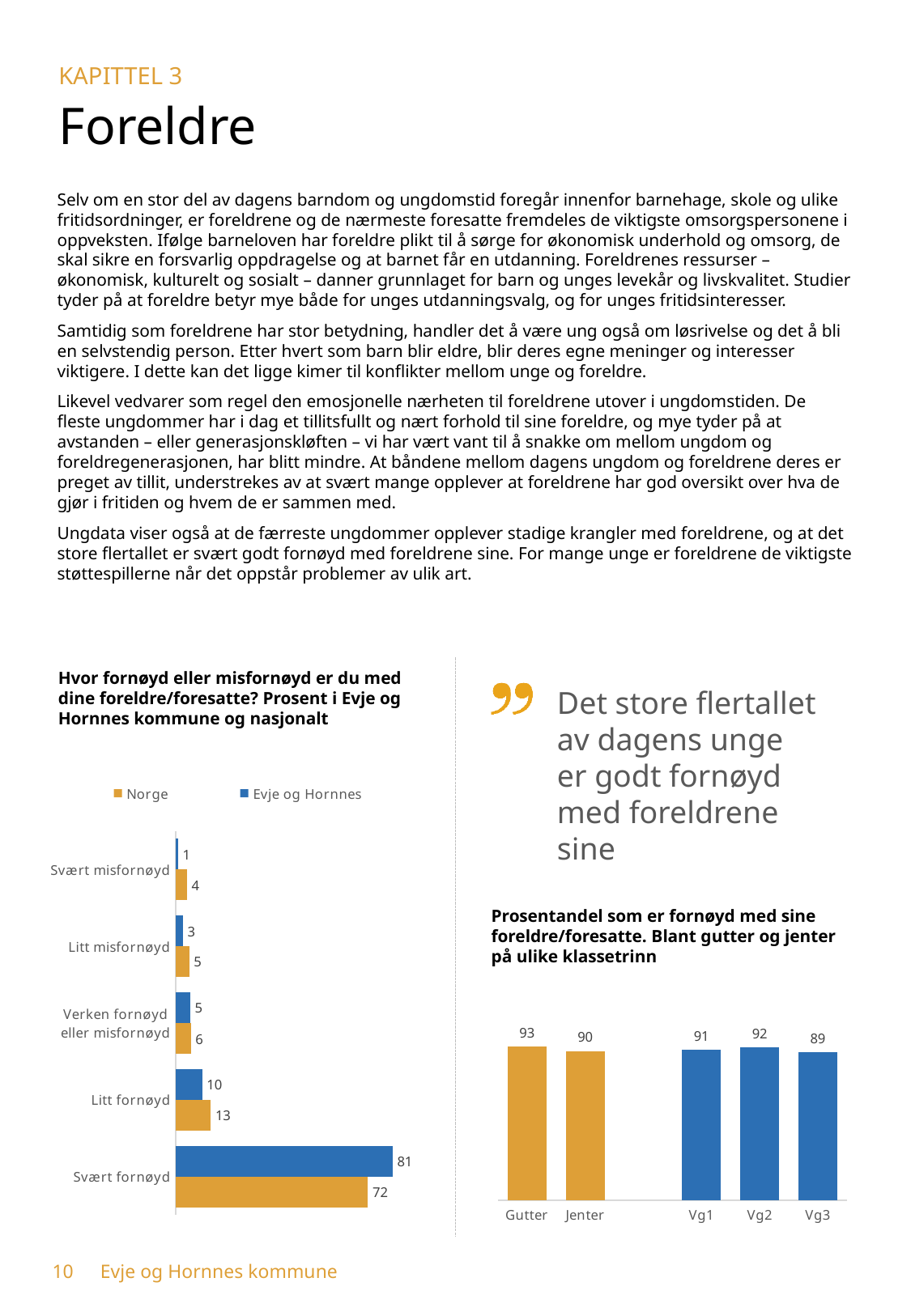
In the left chart on satisfaction with parents, how many categories are shown? 5 In the right chart on the share satisfied with parents, what is the value for Gutter? 93 In the right chart on the share satisfied with parents, which category has the lowest value? Vg3 In the right chart on the share satisfied with parents, what is the difference between Gutter and Jenter? 3 What kind of chart is the right chart on the share satisfied with parents? Bar chart In the left chart on satisfaction with parents, how many series does the legend list? 2 In the left chart on satisfaction with parents, what is the value for Norge in the 'Litt fornøyd' category? 13 In the left chart on satisfaction with parents, what is the difference between Evje og Hornnes and Norge in the 'Svært fornøyd' category? 9 In the left chart on satisfaction with parents, what is the value for Norge in the 'Svært misfornøyd' category? 4 In the left chart on satisfaction with parents, what is the value for Evje og Hornnes in the 'Svært fornøyd' category? 81 In the left chart on satisfaction with parents, which category has the lowest value for Evje og Hornnes? Svært misfornøyd In the left chart on satisfaction with parents, which category has the highest value for Evje og Hornnes? Svært fornøyd